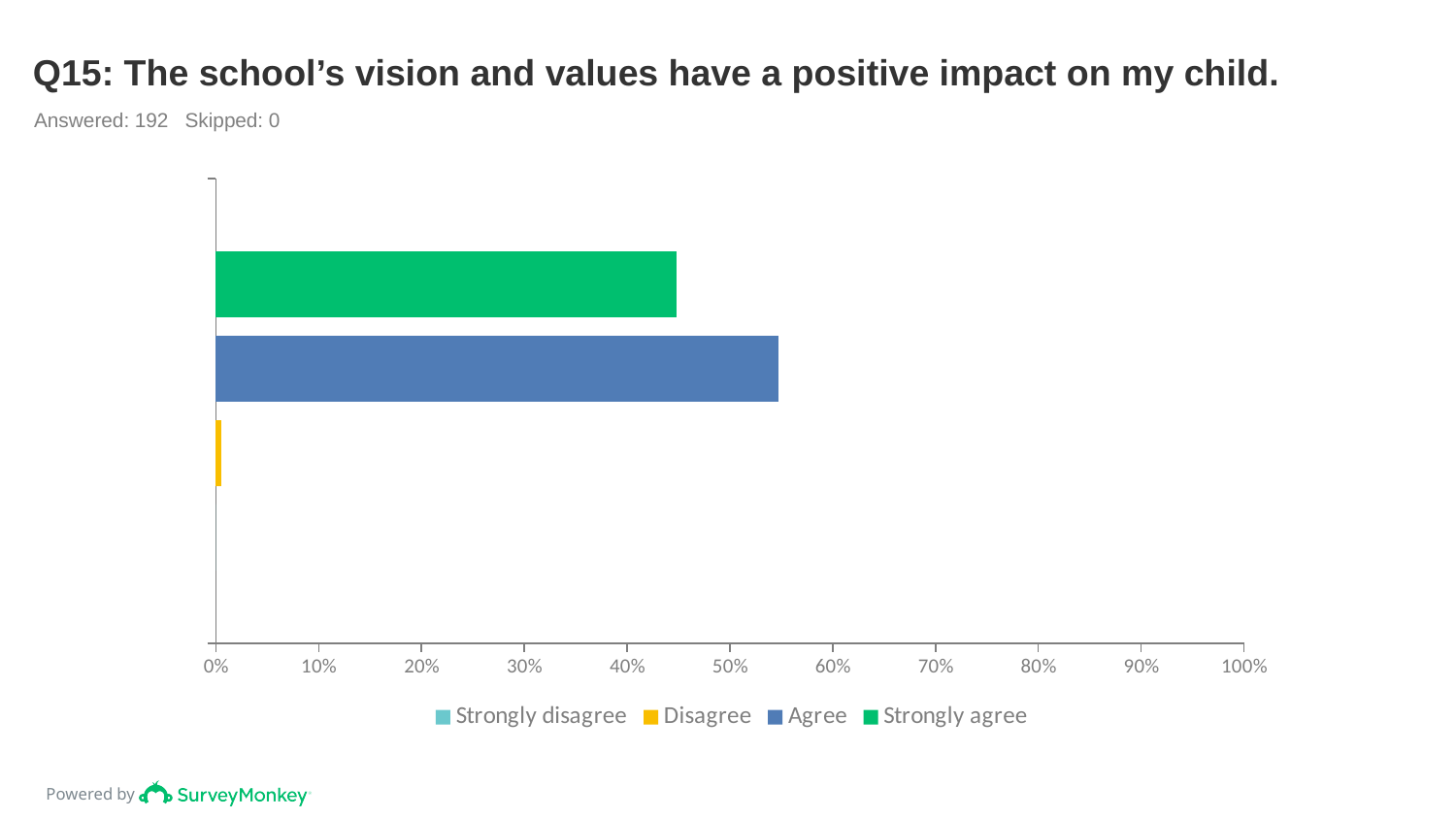
Is the value for Strongly agree greater or less than 40%? greater What is the title of the chart? Q15: The school's vision and values have a positive impact on my child. Which of the two, Disagree or Strongly agree, has the larger value? Strongly agree Which response category has the longest bar? Agree Is the value for Disagree greater or less than 10%? less What kind of chart is shown on the slide? Bar chart Is the value for Strongly agree greater or less than 50%? less How many series does the legend list? 4 Which of the two, Agree or Strongly agree, has the larger value? Agree How many respondents answered the question according to the slide? 192